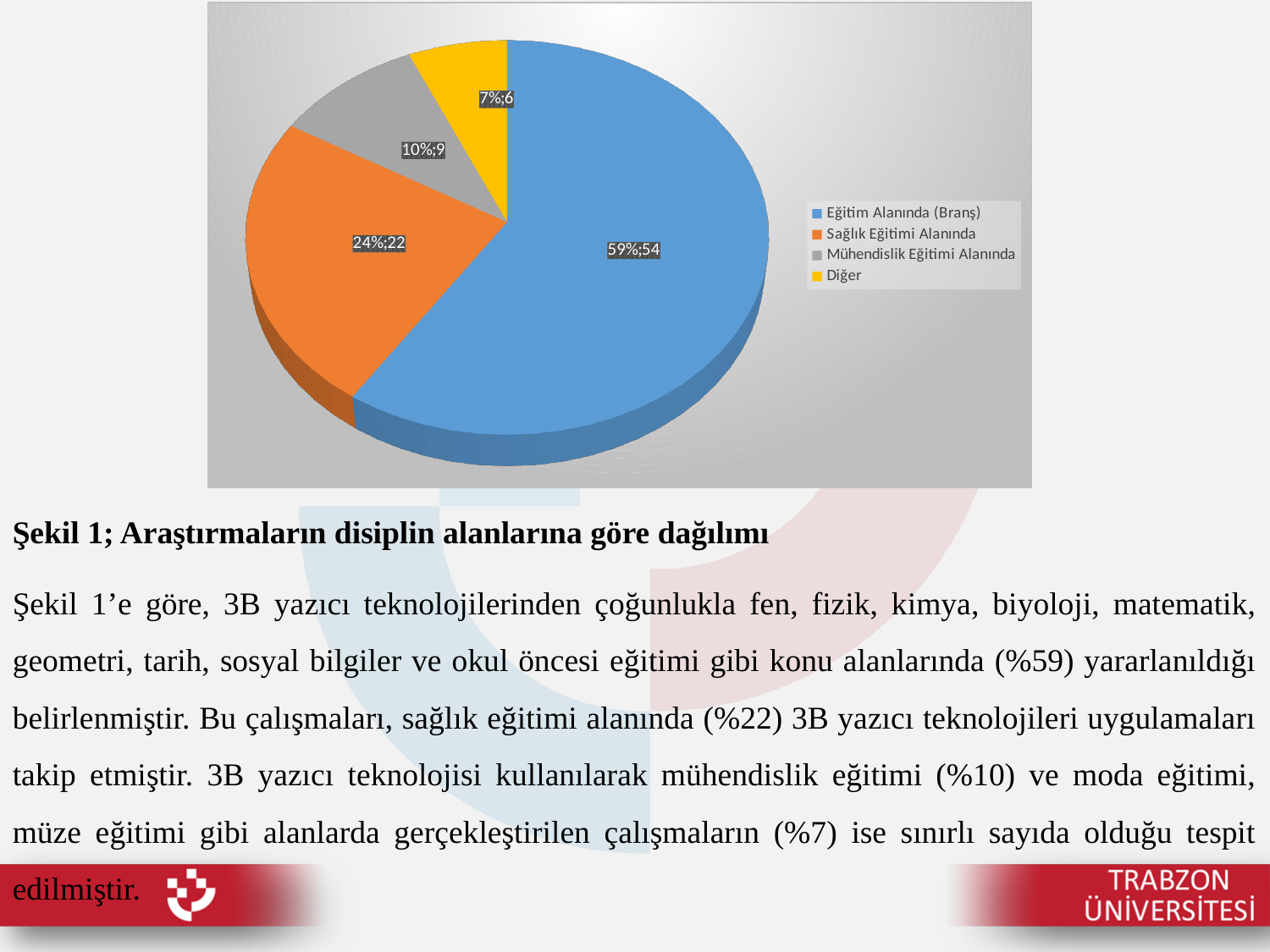
What share of the pie does the Sağlık Eğitimi Alanında slice represent? 24% Which category has the smallest slice of the pie? Diğer What is the data label shown for the Eğitim Alanında (Branş) slice? 59%;54 How many slices does the pie chart have? 4 What is the data label shown for the Mühendislik Eğitimi Alanında slice? 10%;9 Which colour is used for the Diğer slice in the pie chart? Yellow What kind of chart is shown on the slide? Pie chart What is the data label shown for the Diğer slice? 7%;6 What is the difference in count between the Eğitim Alanında (Branş) slice (54) and the Sağlık Eğitimi Alanında slice (22)? 32 Which category has the largest slice of the pie? Eğitim Alanında (Branş) How many entries does the legend of the pie chart list? 4 What is the data label shown for the Sağlık Eğitimi Alanında slice? 24%;22